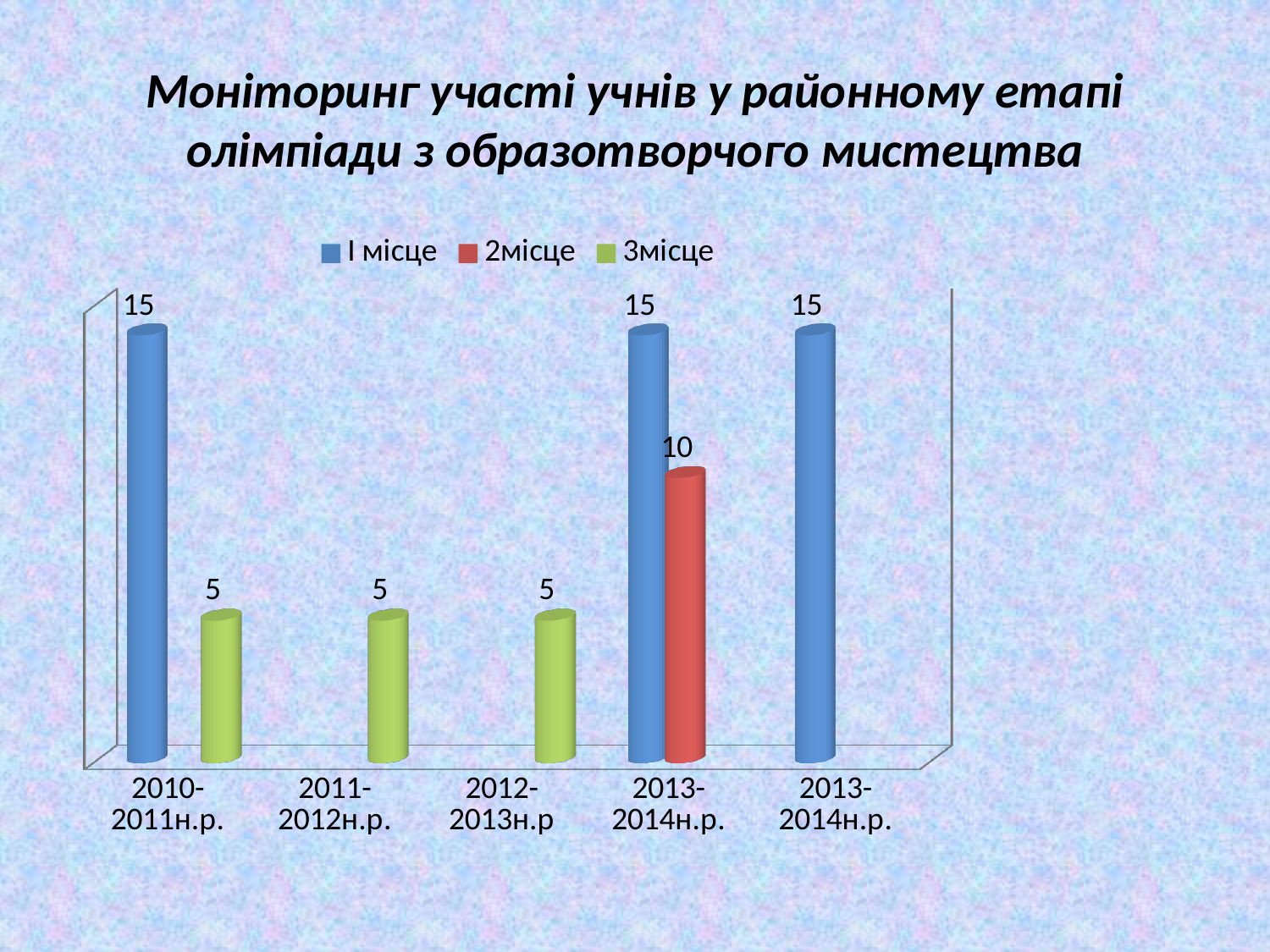
How many series does the legend list? 3 What is the highest value shown by any bar in the chart? 15 What type of chart is shown on the slide? bar chart What is the value of the 3місце bar for 2012-2013н.р? 5 Which is larger for 2010-2011н.р., the І місце value or the 3місце value? І місце What is the value of the 3місце bar for 2011-2012н.р.? 5 What is the value of the only 2місце bar in the chart? 10 What is the value of the 3місце bar for 2010-2011н.р.? 5 How many category groups are shown along the x axis? 5 What is the value of the І місце bar for 2010-2011н.р.? 15 Which series is shown in red in the legend? 2місце What is the difference between the І місце and 3місце values for 2010-2011н.р.? 10